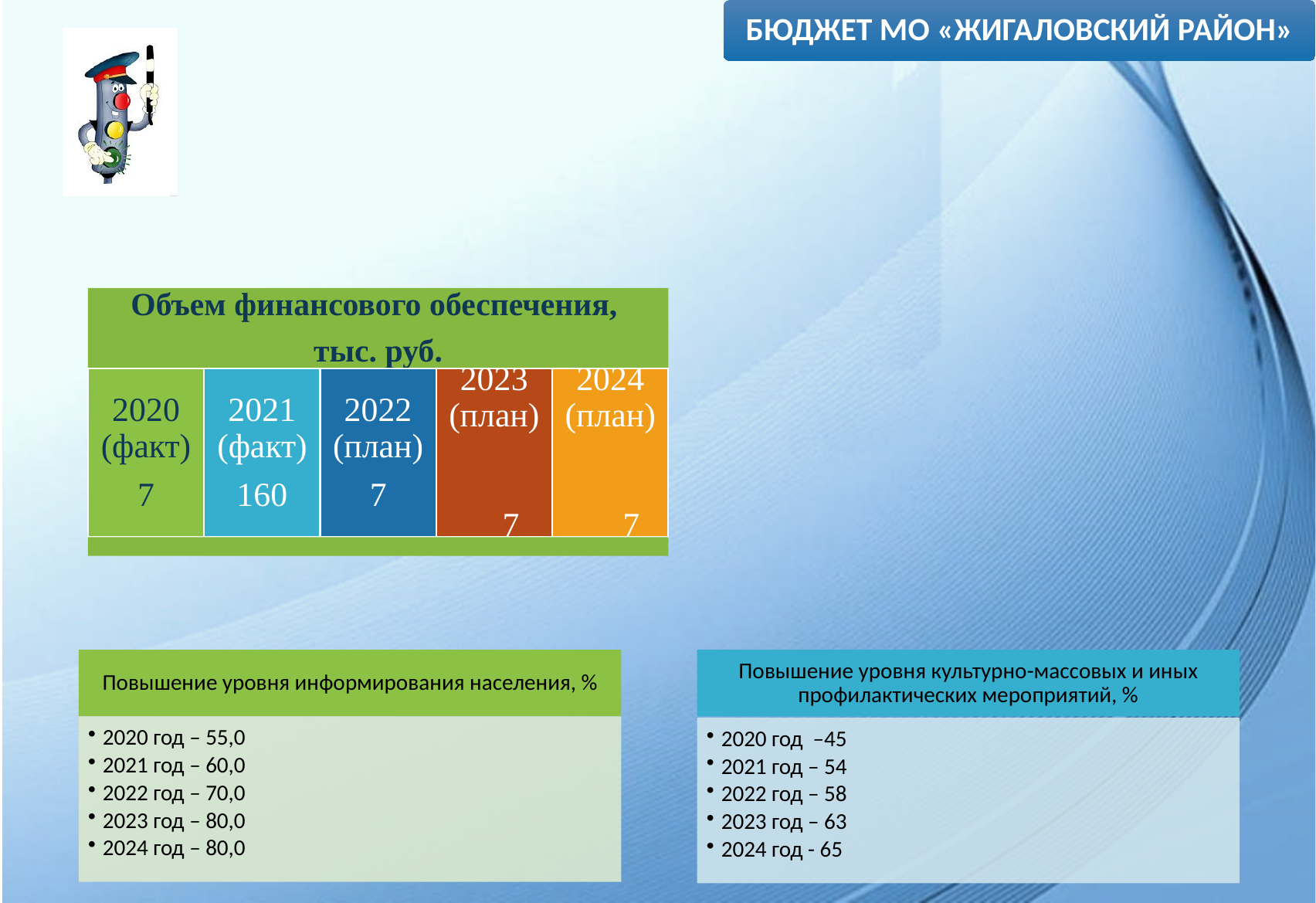
In the 'Объем финансового обеспечения, тыс. руб.' graphic, what is the difference between the 2021 (факт) value and the 2022 (план) value? 153 In the 'Объем финансового обеспечения, тыс. руб.' graphic, what is the value for 2021 (факт)? 160 In the 'Объем финансового обеспечения, тыс. руб.' graphic, which years are marked as 'план'? 2022, 2023, 2024 In the 'Объем финансового обеспечения, тыс. руб.' graphic, what is the planned value for 2024? 7 In the 'Повышение уровня информирования населения, %' box, what is the value for 2022? 70,0 In the 'Повышение уровня информирования населения, %' box, do the values rise or fall from 2020 to 2024? rise In the 'Объем финансового обеспечения, тыс. руб.' graphic, which is larger: the value for 2021 (факт) or the value for 2023 (план)? 2021 (факт) In the 'Объем финансового обеспечения, тыс. руб.' graphic, what is the value for 2020 (факт)? 7 In the 'Повышение уровня культурно-массовых и иных профилактических мероприятий, %' box, what is the value for 2024? 65 In the 'Объем финансового обеспечения, тыс. руб.' graphic, which year has the highest value? 2021 (факт) In the 'Повышение уровня культурно-массовых и иных профилактических мероприятий, %' box, what is the difference between the 2024 value and the 2020 value? 20 How many years are shown in the 'Объем финансового обеспечения, тыс. руб.' graphic? 5